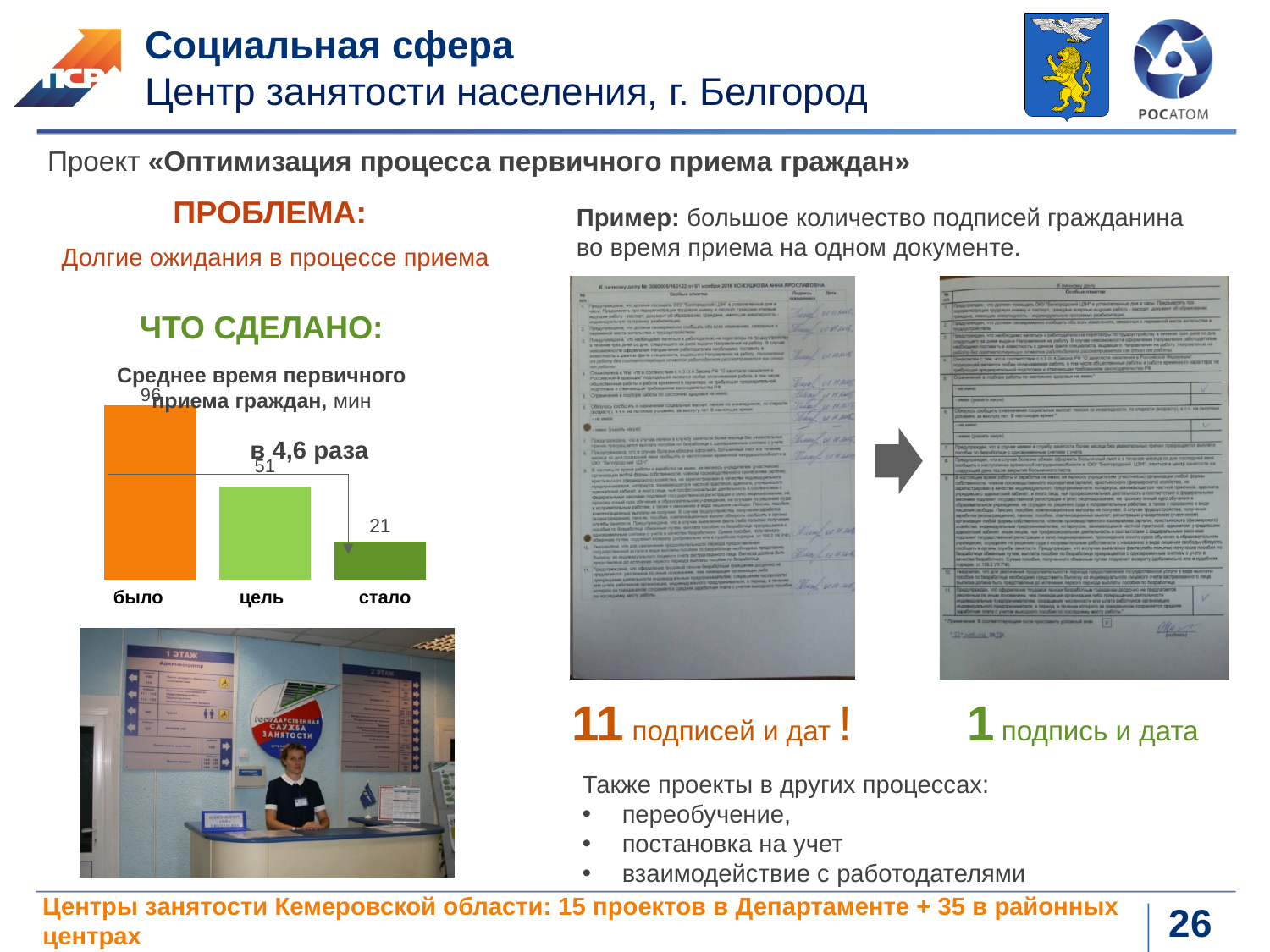
How many categories are shown in the chart? 3 Which is larger, the value for "цель" or the value for "стало"? цель What is the difference between the values for "цель" and "стало"? 30 Do the values rise or fall from left to right across the categories in the chart? fall What is the difference between the values for "было" and "стало"? 75 What kind of chart is shown on the slide? bar chart What is the value for "цель" in the chart? 51 Which category has the lowest value in the chart? стало What is the value for "стало" in the chart? 21 Which category has the highest value in the chart? было What unit is stated in the chart title? мин What is the value for "было" in the chart "Среднее время первичного приема граждан, мин"? 96